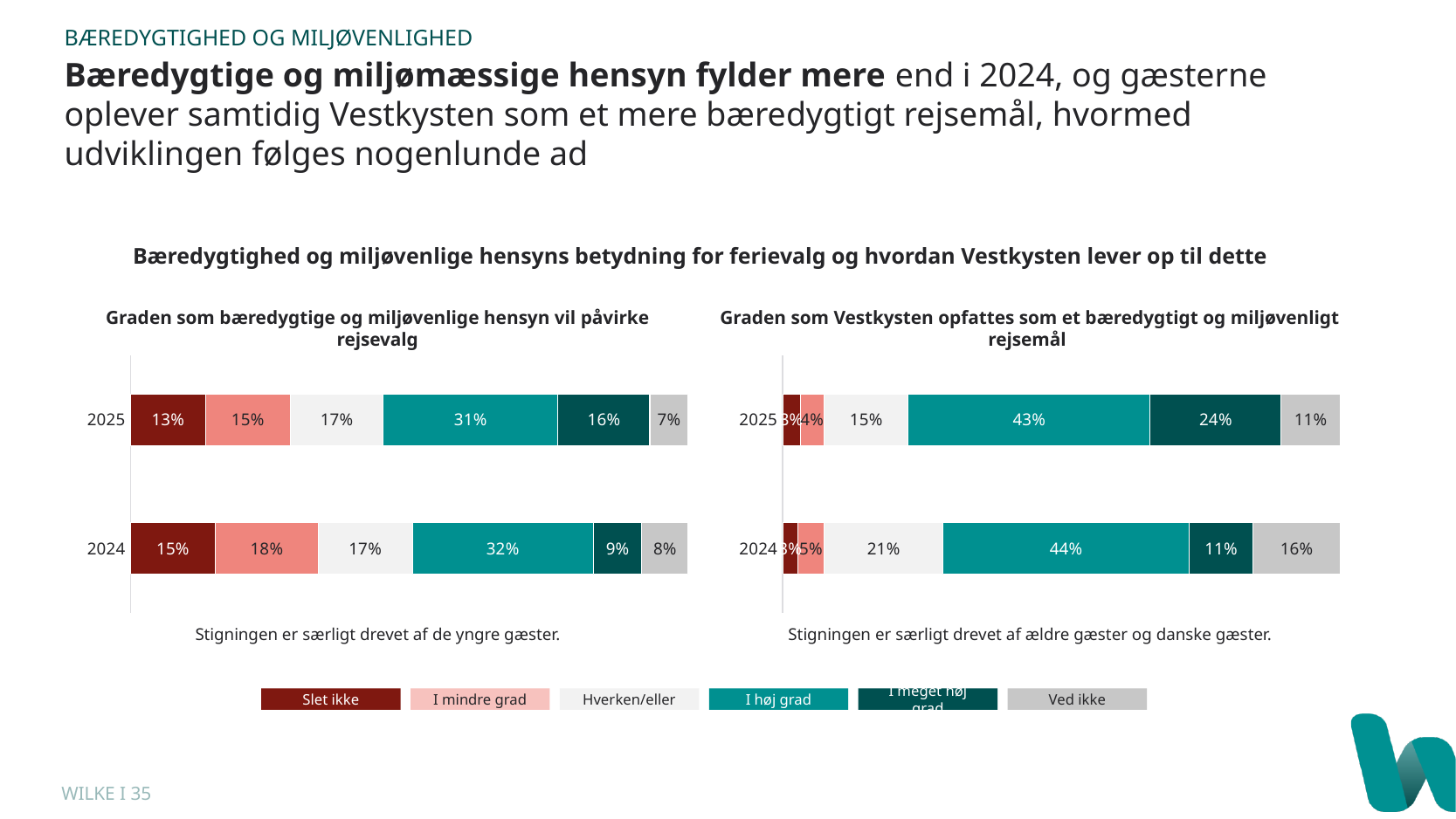
In the left chart (Graden som bæredygtige og miljøvenlige hensyn vil påvirke rejsevalg), what is the value for 'I høj grad' in 2025? 31% In the left chart, which year has the larger 'Slet ikke' value, 2025 or 2024? 2024 In the right chart, which segment is the largest in the 2024 bar? I høj grad In the right chart (Graden som Vestkysten opfattes som et bæredygtigt og miljøvenligt rejsemål), what is the value for 'I høj grad' in 2025? 43% In the left chart (Graden som bæredygtige og miljøvenlige hensyn vil påvirke rejsevalg), what is the value for 'I meget høj grad' in 2024? 9% In the right chart, which year has the larger 'I meget høj grad' value, 2025 or 2024? 2025 In the right chart, what is the difference between the 'Hverken/eller' values for 2024 and 2025? 6 percentage points What kind of chart is used on this slide? Stacked bar chart How many series does the legend list? 6 In the left chart, what is the difference between the 'I meget høj grad' values for 2025 and 2024? 7 percentage points How many years (categories) are shown in each chart? 2 In the right chart (Graden som Vestkysten opfattes som et bæredygtigt og miljøvenligt rejsemål), what is the value for 'Ved ikke' in 2024? 16%